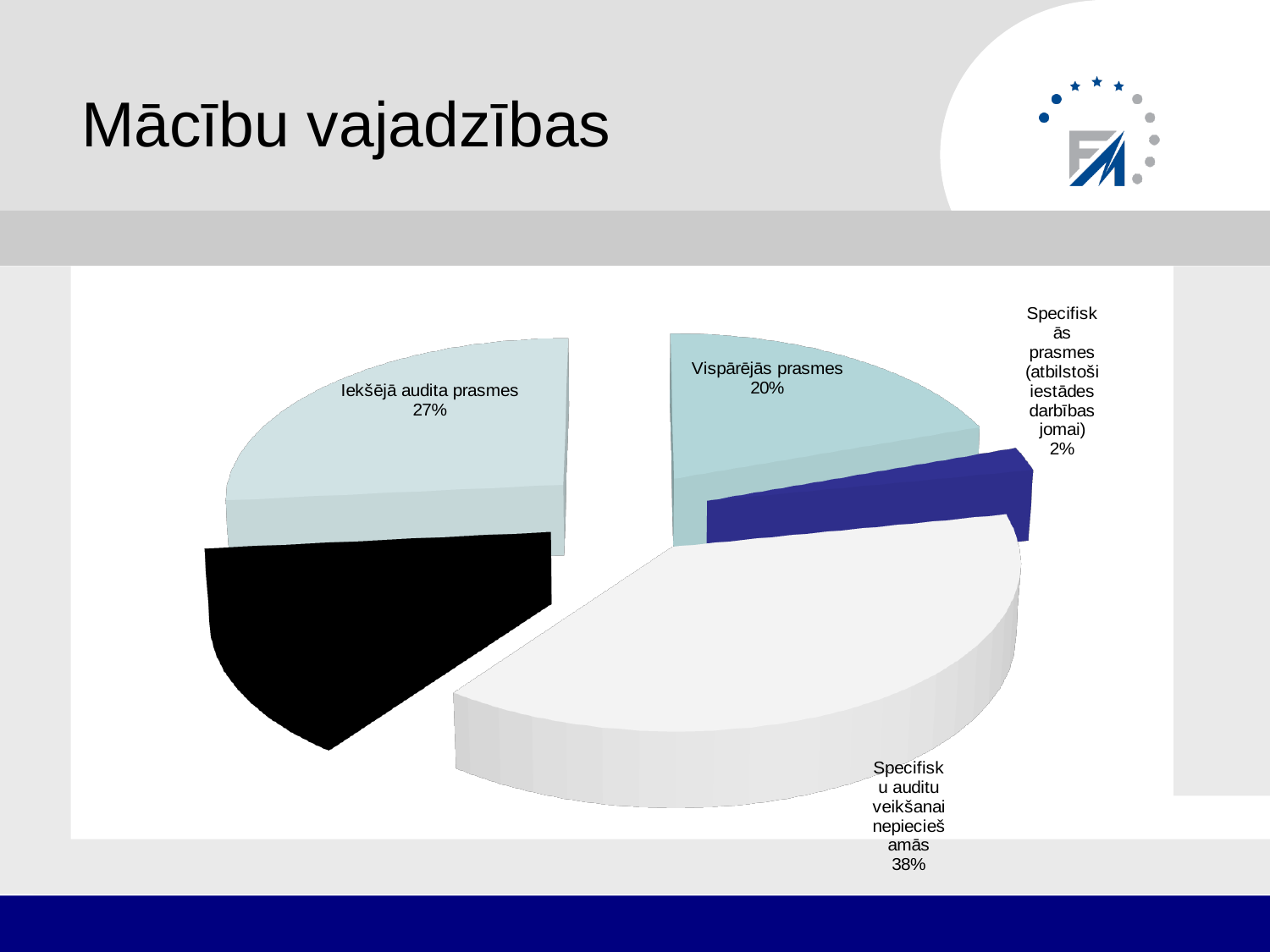
Which labelled category has the smallest share of the pie? Specifiskās prasmes (atbilstoši iestādes darbības jomai) What percentage does the slice labelled "Iekšējā audita prasmes" represent? 27% What kind of chart is shown on the slide? Pie chart Which labelled category has the largest share of the pie? Specifisku auditu veikšanai nepieciešamās What percentage is shown for "Specifiskās prasmes (atbilstoši iestādes darbības jomai)"? 2% What is the difference in percentage points between "Specifisku auditu veikšanai nepieciešamās" and "Iekšējā audita prasmes"? 11 What percentage is shown for "Specifisku auditu veikšanai nepieciešamās"? 38% How many slices of the pie are labelled with a percentage? 4 Which is larger: the share for "Vispārējās prasmes" or the share for "Iekšējā audita prasmes"? Iekšējā audita prasmes What is the difference in percentage points between "Iekšējā audita prasmes" and "Vispārējās prasmes"? 7 What percentage does the slice labelled "Vispārējās prasmes" represent? 20% What is the title of the slide containing the chart? Mācību vajadzības